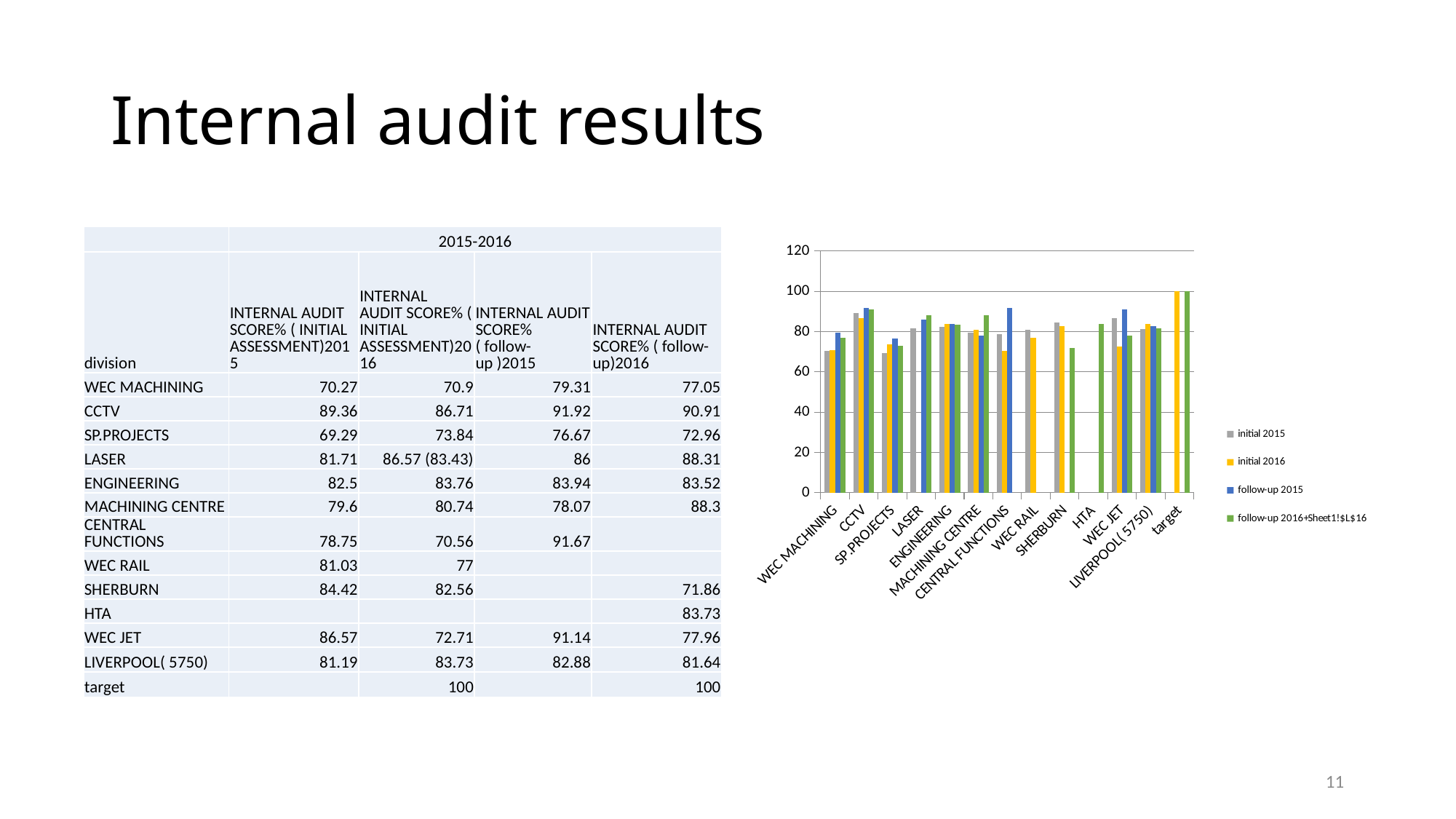
Is the initial 2015 value for WEC MACHINING greater or less than 80? less Is the follow-up 2015 value for CENTRAL FUNCTIONS greater or less than 80? greater For the initial 2015 series, which is larger: CCTV or SP.PROJECTS? CCTV What kind of chart is shown on the slide? bar chart Which category has the highest initial 2016 value? target How many series does the chart legend list? 4 What colour represents the initial 2016 series in the chart? yellow Is the follow-up 2015 value for CCTV greater or less than 80? greater Which series is the only one with a bar for HTA? follow-up 2016+Sheet1!$L$16 How many categories are shown on the x axis of the chart? 13 What is the value of the initial 2016 bar for target? 100